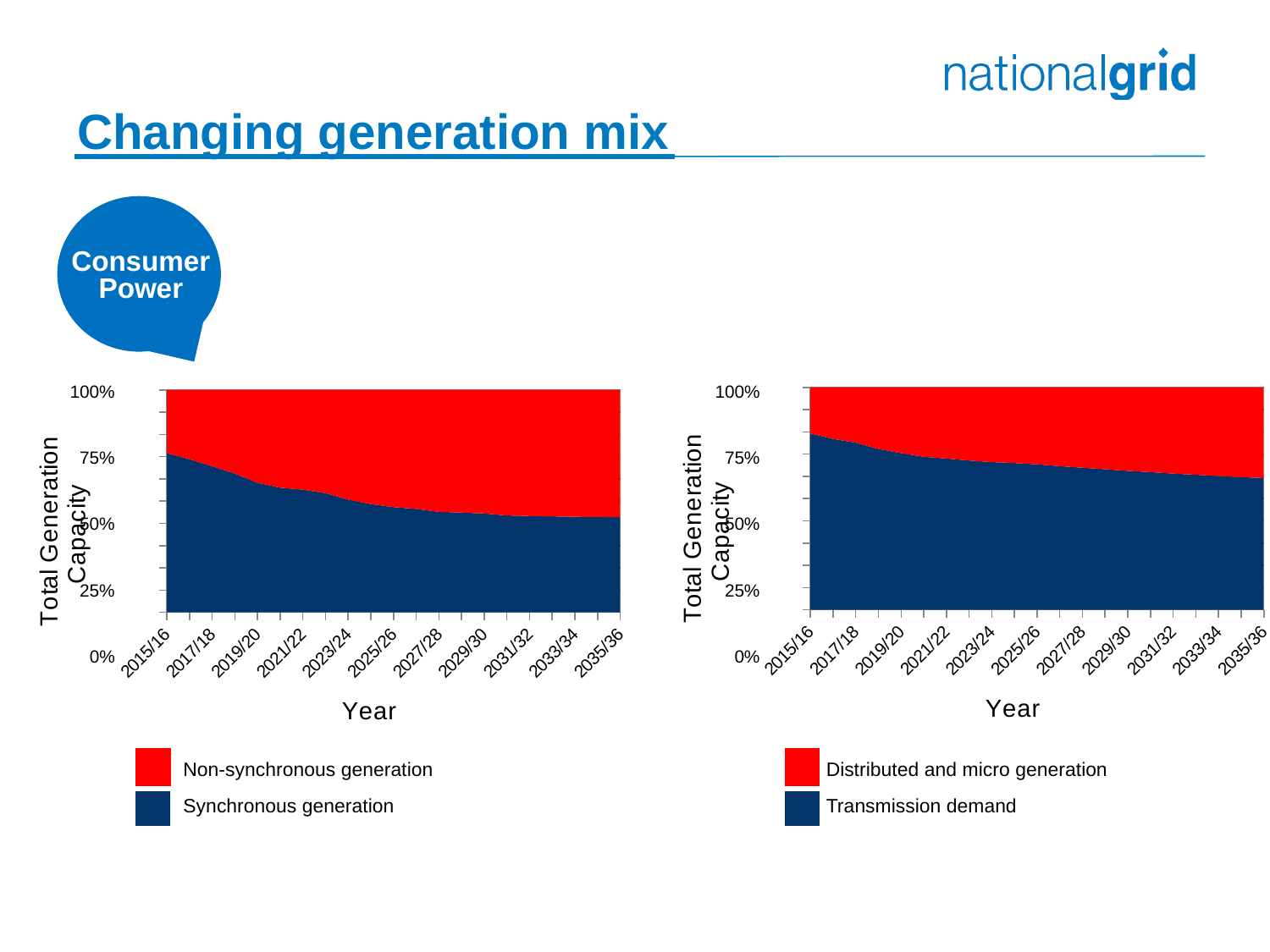
In the left chart, does the share of Synchronous generation rise or fall from 2015/16 to 2035/36? Fall How many year labels are shown on the x axis of the right chart? 11 What kind of chart is the left chart on the slide? Stacked area chart In the right chart, is the share of Transmission demand in 2015/16 greater or less than 75%? greater In the right chart, does the share of Transmission demand rise or fall from 2015/16 to 2035/36? Fall How many series does the legend of the left chart list? 2 In the right chart, which series is shown in red? Distributed and micro generation In the left chart, does the share of Non-synchronous generation rise or fall from 2015/16 to 2035/36? Rise In the left chart, is the share of Synchronous generation in 2015/16 greater or less than 50%? greater In the left chart, is the share of Synchronous generation in 2035/36 greater or less than 75%? less How many series does the legend of the right chart list? 2